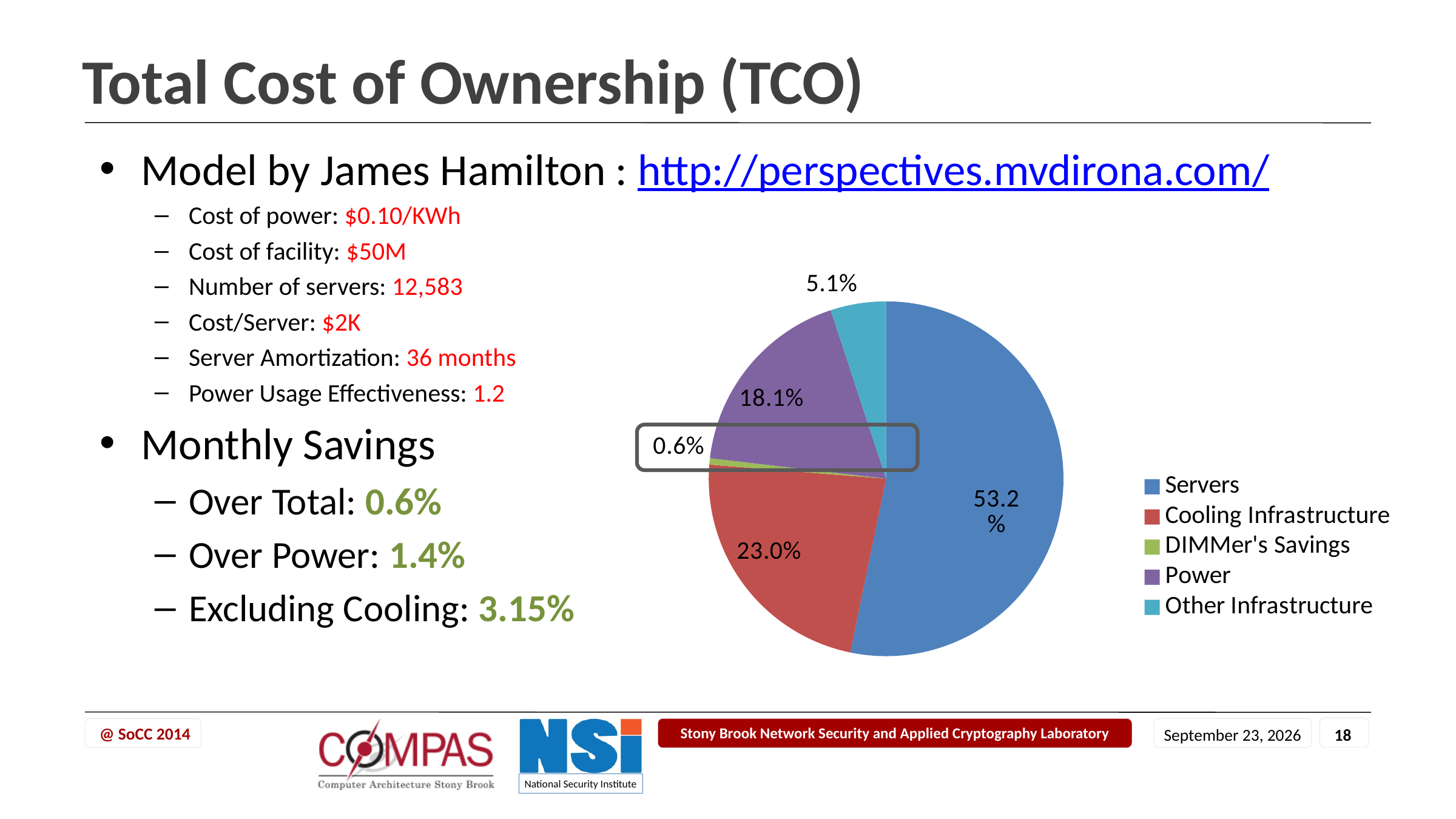
What share of the pie does DIMMer's Savings take? 0.6% What colour is the Power slice in the pie chart? purple How many slices does the pie chart have? 5 What share of the pie does Servers take? 53.2% What kind of chart is shown on the slide? pie chart Which slice of the pie is the largest? Servers Which slice of the pie is the smallest? DIMMer's Savings Which is larger, the Power slice or the Other Infrastructure slice? Power What share of the pie does Other Infrastructure take? 5.1% What share of the pie does Cooling Infrastructure take? 23.0% What is the difference between the Servers share and the Cooling Infrastructure share? 30.2% What share of the pie does Power take? 18.1%